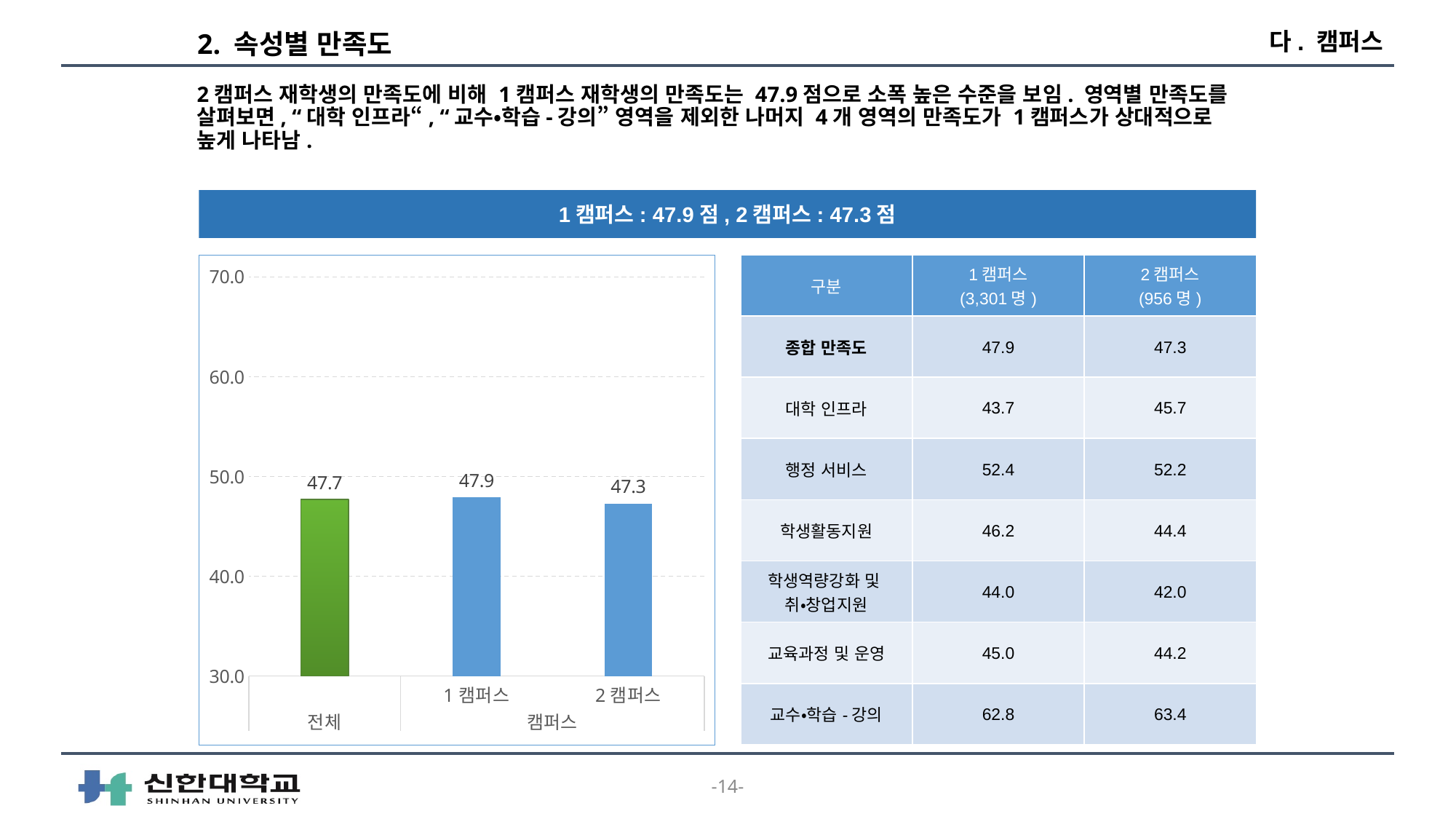
Is the value for 2 캠퍼스 in the bar chart greater or less than 50.0? less Which is larger in the bar chart, the value for 1 캠퍼스 or the value for 2 캠퍼스? 1 캠퍼스 Which category has the lowest value in the bar chart? 2 캠퍼스 Which category has the highest value in the bar chart? 1 캠퍼스 What is the value for 1 캠퍼스 in the bar chart? 47.9 What kind of chart is shown on the slide? bar chart What colour is the 전체 bar in the chart? green What is the difference between the values for 1 캠퍼스 and 전체 in the bar chart? 0.2 What is the value for 전체 in the bar chart? 47.7 What is the difference between the values for 1 캠퍼스 and 2 캠퍼스 in the bar chart? 0.6 How many bars are plotted in the bar chart? 3 What is the value for 2 캠퍼스 in the bar chart? 47.3